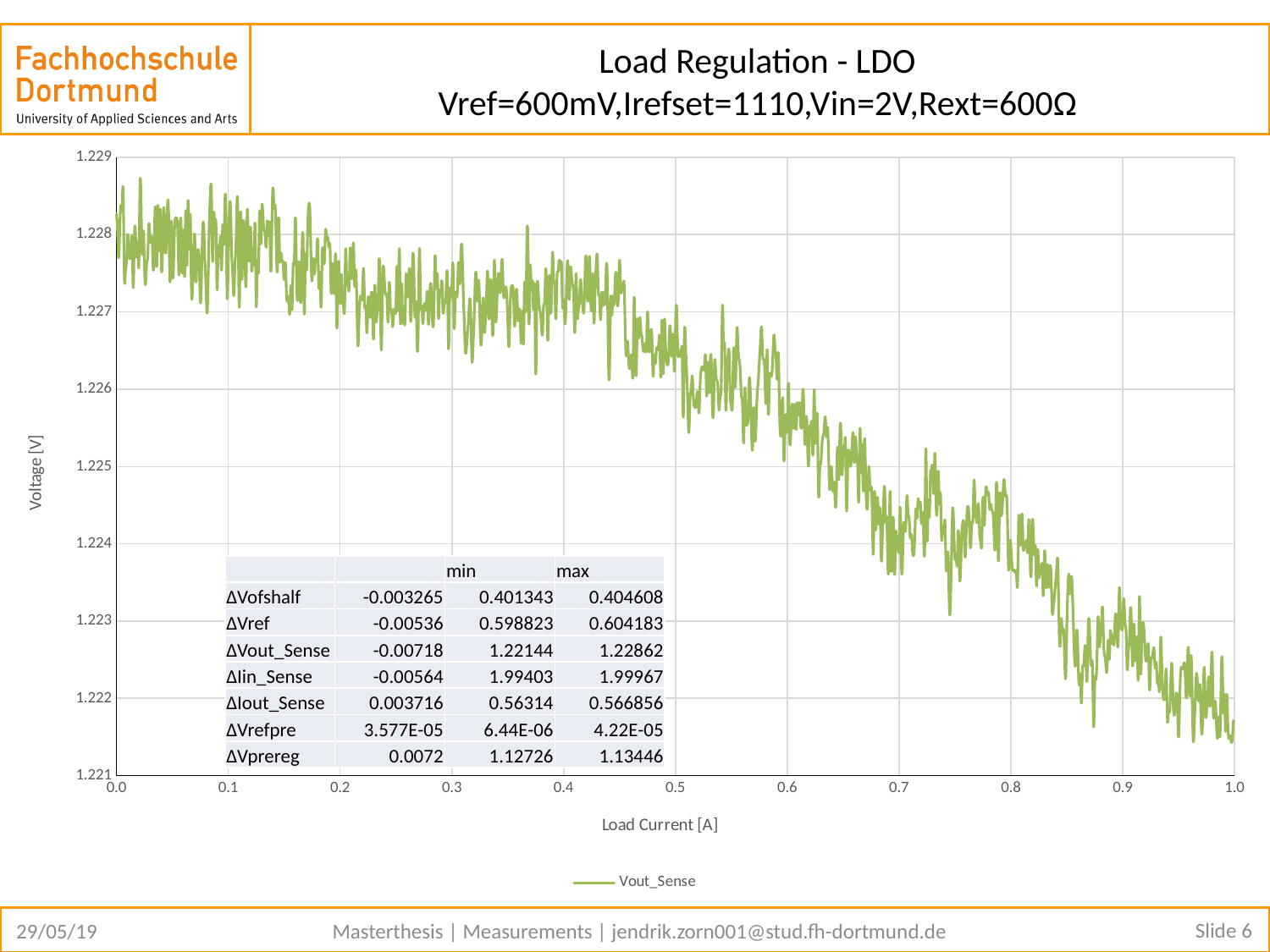
Is the Vout_Sense value at a load current of 0.0 A greater or less than 1.227 V? greater Does the Vout_Sense voltage rise or fall as the load current increases from 0.0 to 1.0 A? fall How many series does the chart legend list? 1 What is the name of the series shown in the chart legend? Vout_Sense What is the label of the x axis of the chart? Load Current [A] What kind of chart is shown on the slide? line chart Is the Vout_Sense value at a load current of 0.5 A greater or less than 1.225 V? greater Is the Vout_Sense value at a load current of 0.9 A greater or less than 1.224 V? less In the table on the chart, what is the min value listed for ΔVref? 0.598823 In the table on the chart, what is the max value listed for ΔVout_Sense? 1.22862 Is the Vout_Sense voltage higher at a load current of 0.2 A or at 0.8 A? 0.2 A